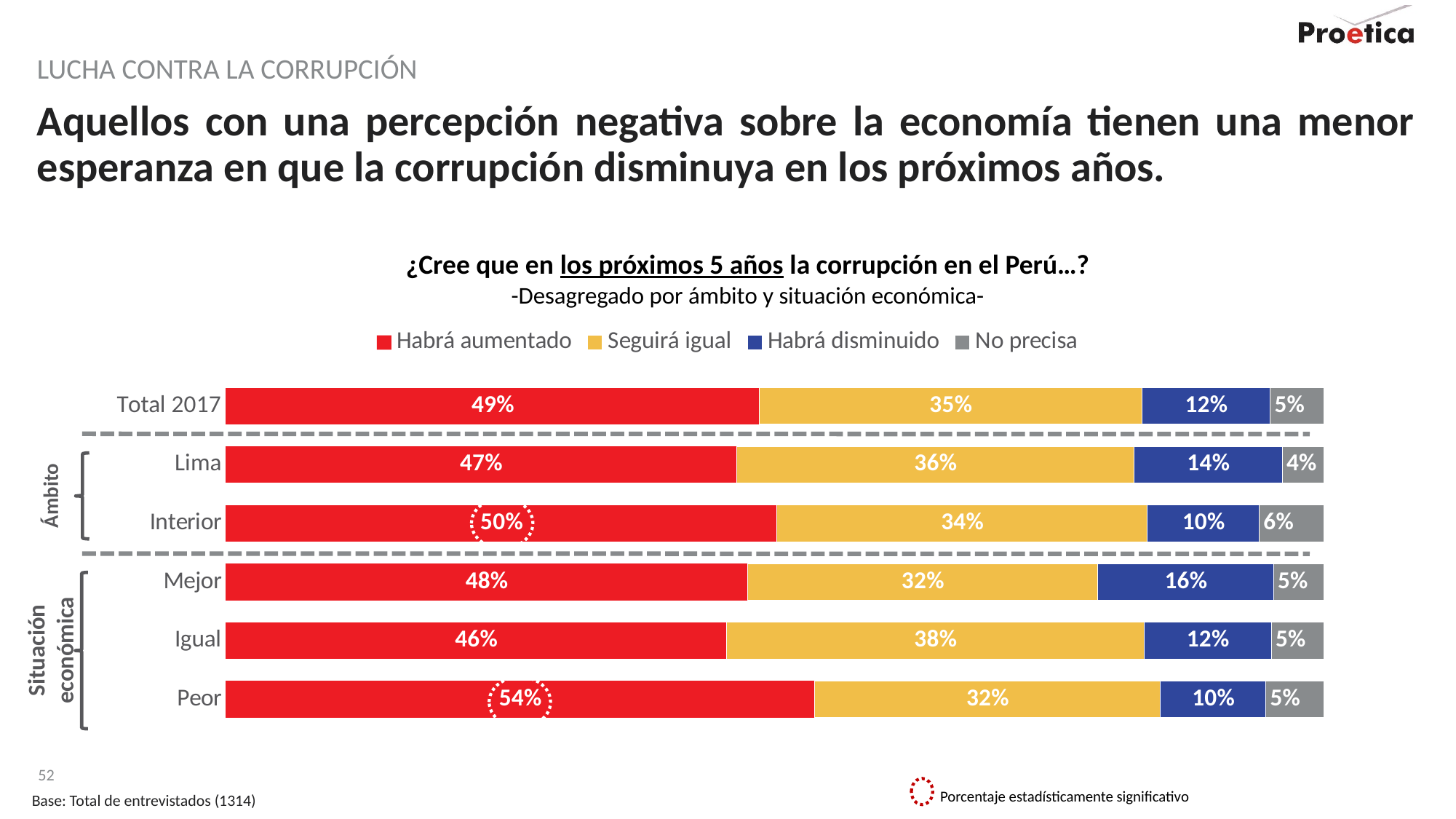
What is the difference between the 'Habrá aumentado' values for 'Peor' and 'Igual'? 8 percentage points How many categories (bars) are shown in the chart? 6 Which category has the lowest 'Habrá disminuido' value? Interior and Peor (10%) How many series does the legend list? 4 Which colour represents 'Seguirá igual' in the chart? Yellow What percentage of the 'Peor' group answered 'Habrá aumentado'? 54% What kind of chart is shown on the slide? Stacked bar chart What is the 'No precisa' value for 'Interior'? 6% What is the 'Seguirá igual' value for 'Igual'? 38% Which has a larger 'Habrá disminuido' value, Lima or Interior? Lima Which category has the highest 'Habrá aumentado' value? Peor What is the 'Habrá disminuido' value for 'Mejor'? 16%